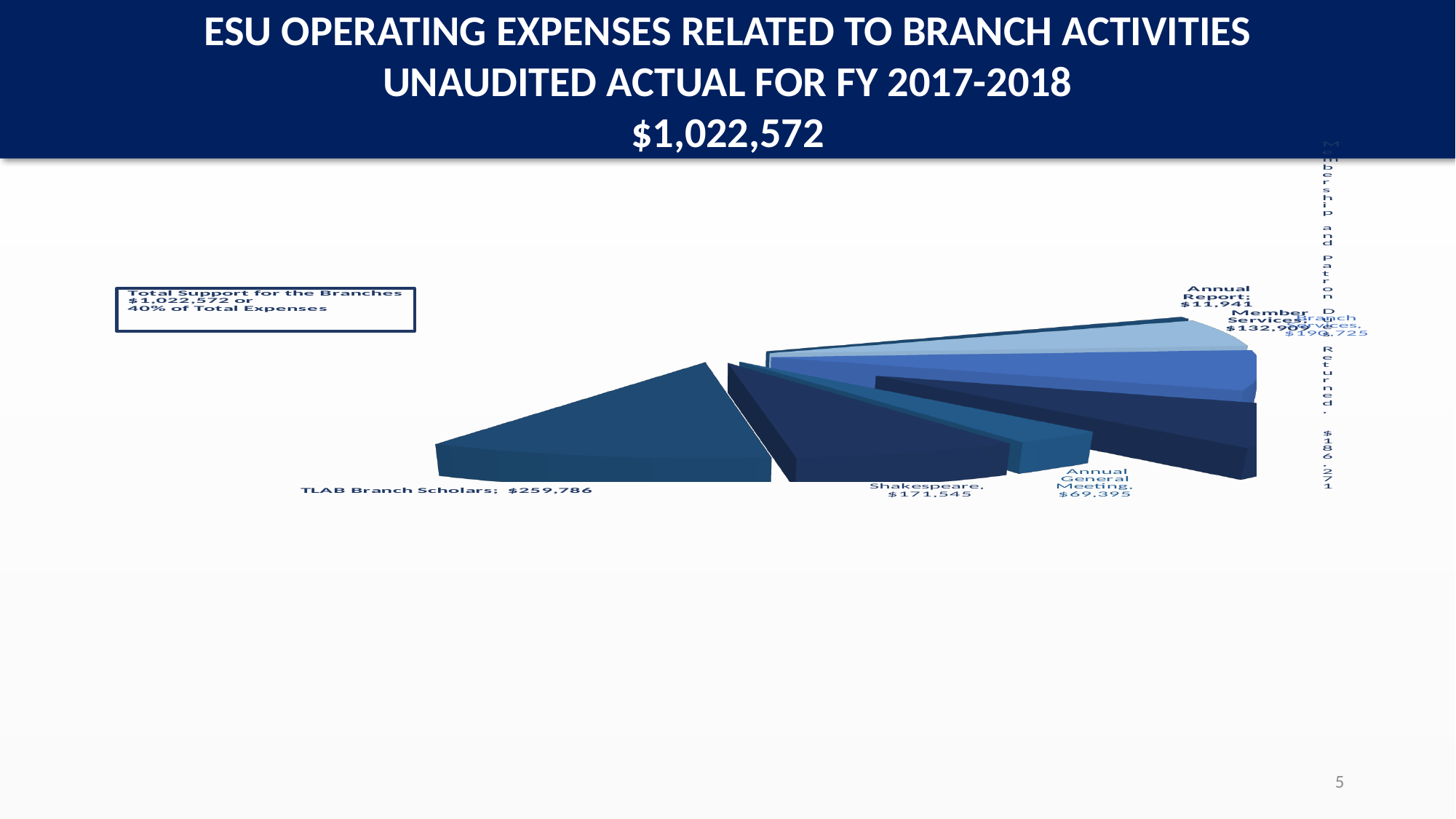
What is the value for TLAB Branch Scholars? $259,786 Which is larger, the value for Shakespeare or the value for Annual General Meeting? Shakespeare What is the value for Annual General Meeting? $69,395 According to the text box, what percentage of total expenses does the total support for the branches represent? 40% What is the value for Annual Report? $11,941 What total amount is given in the slide title? $1,022,572 What kind of chart is shown on the slide? pie chart What is the value for Shakespeare? $171,545 What is the difference between the values for TLAB Branch Scholars and Shakespeare? $88,241 What is the difference between the values for Shakespeare and Annual General Meeting? $102,150 Which category has the smallest slice of the pie? Annual Report